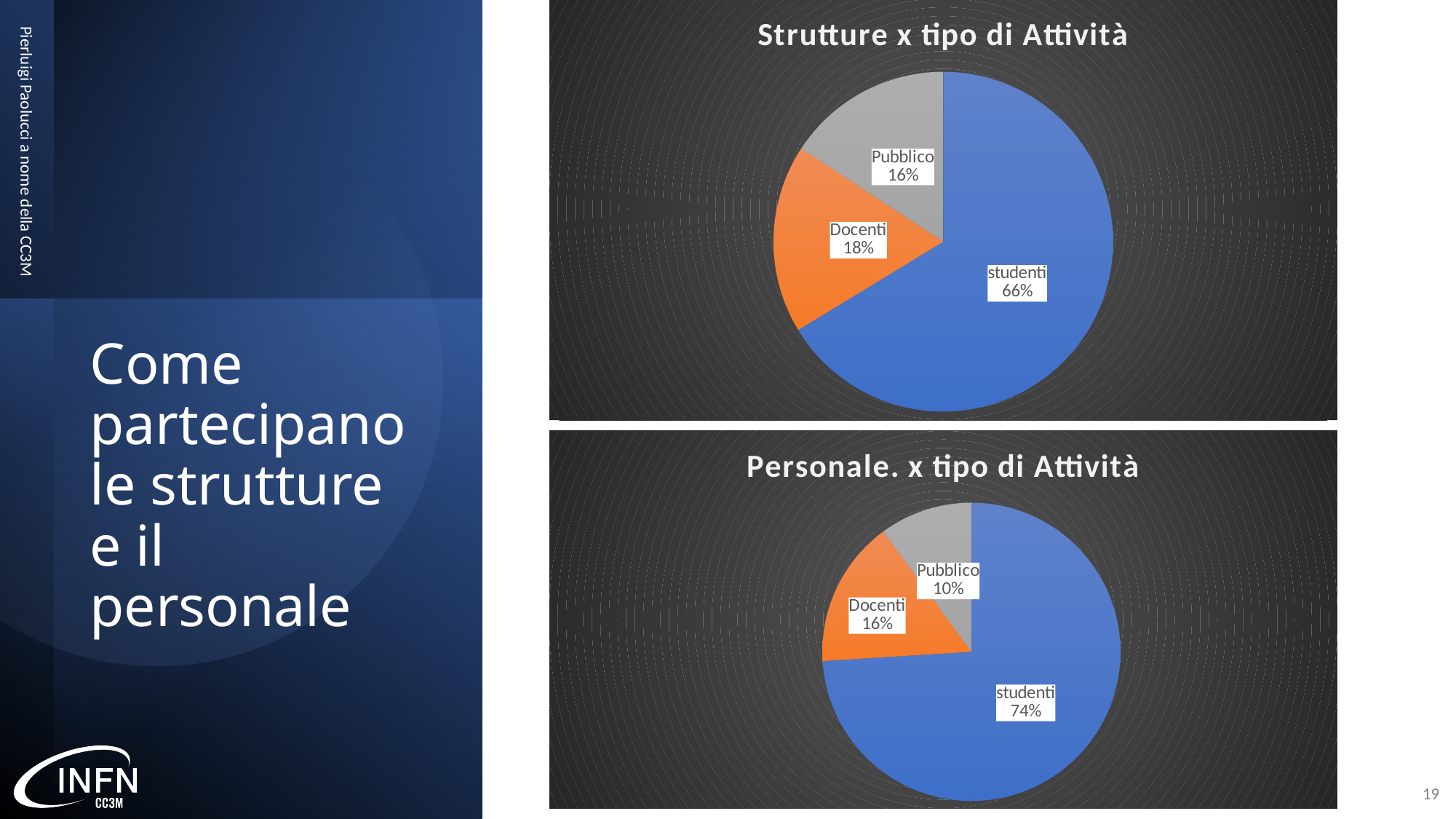
What type of chart is 'Strutture x tipo di Attività'? Pie chart In the 'Personale. x tipo di Attività' chart, which category has the smallest slice? Pubblico In the 'Personale. x tipo di Attività' chart, what share is labelled for Pubblico? 10% In the 'Strutture x tipo di Attività' chart, which category has the largest slice? studenti In the 'Strutture x tipo di Attività' chart, what share is labelled for studenti? 66% In the 'Strutture x tipo di Attività' chart, what share is labelled for Docenti? 18% In the 'Strutture x tipo di Attività' chart, what share is labelled for Pubblico? 16% In the 'Personale. x tipo di Attività' chart, what share is labelled for studenti? 74% What colour is the studenti slice in the 'Personale. x tipo di Attività' chart? Blue In the 'Strutture x tipo di Attività' chart, which is larger, Docenti or Pubblico? Docenti How many slices does the 'Personale. x tipo di Attività' chart have? 3 In the 'Personale. x tipo di Attività' chart, what is the difference in percentage points between studenti and Docenti? 58